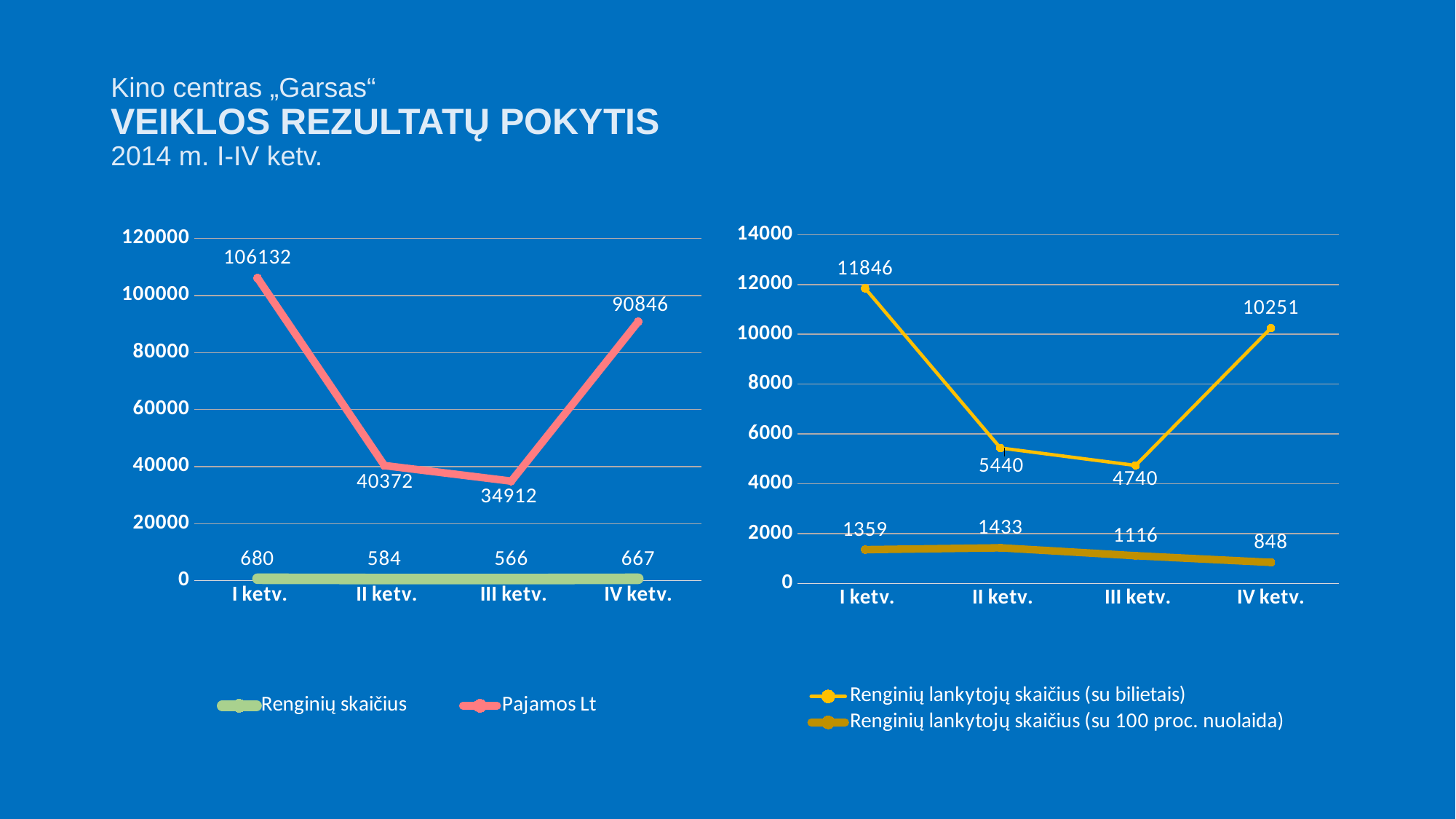
What kind of chart is the left chart? line chart In the right chart, in which quarter is Renginių lankytojų skaičius (su bilietais) highest? I ketv. In the right chart, which is larger: Renginių lankytojų skaičius (su 100 proc. nuolaida) in I ketv. or in IV ketv.? I ketv. In the left chart, in which quarter is Pajamos Lt lowest? III ketv. In the left chart, what is the value of Renginių skaičius for III ketv.? 566 In the right chart, what is the value of Renginių lankytojų skaičius (su bilietais) for II ketv.? 5440 In the left chart, what is the value of Pajamos Lt for I ketv.? 106132 In the right chart, how many quarters are plotted on the x axis? 4 In the left chart, how many series does the legend list? 2 In the right chart, what is the value of Renginių lankytojų skaičius (su 100 proc. nuolaida) for IV ketv.? 848 In the left chart, what is the difference between Pajamos Lt in I ketv. and IV ketv.? 15286 In the right chart, does Renginių lankytojų skaičius (su 100 proc. nuolaida) rise or fall from II ketv. to IV ketv.? fall